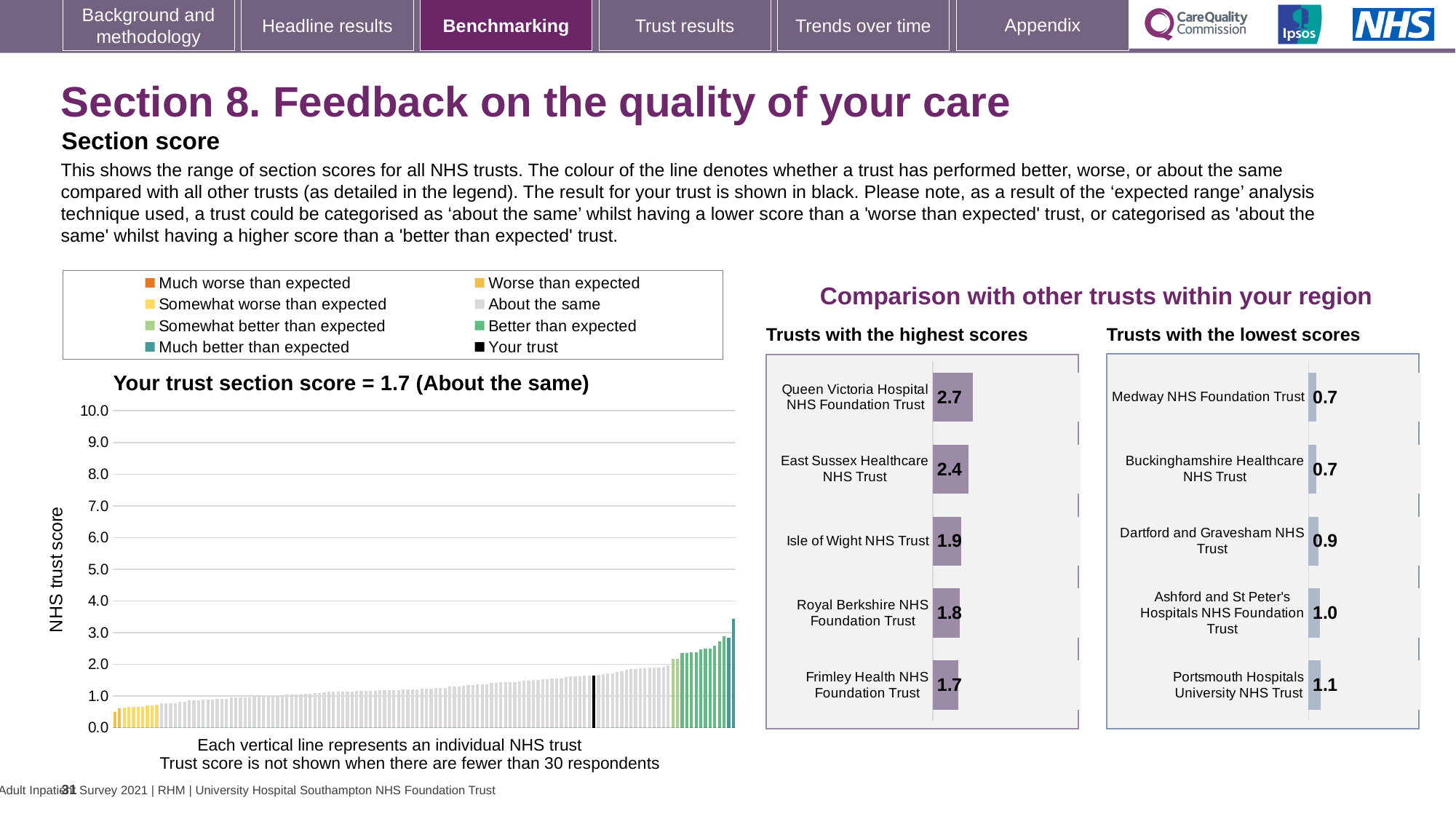
In the 'Trusts with the lowest scores' chart, what is the difference between the scores of Portsmouth Hospitals University NHS Trust and Medway NHS Foundation Trust? 0.4 In the 'Trusts with the lowest scores' chart, which trust has the highest score? Portsmouth Hospitals University NHS Trust In the 'Your trust section score' chart, what is the section score for your trust? 1.7 In the 'Trusts with the highest scores' chart, what is the score for Isle of Wight NHS Trust? 1.9 In the 'Trusts with the lowest scores' chart, what is the score for Dartford and Gravesham NHS Trust? 0.9 In the 'Trusts with the highest scores' chart, which has the larger score: East Sussex Healthcare NHS Trust or Royal Berkshire NHS Foundation Trust? East Sussex Healthcare NHS Trust In the 'Trusts with the highest scores' chart, which trust has the lowest score? Frimley Health NHS Foundation Trust In the 'Trusts with the highest scores' chart, what is the score for Queen Victoria Hospital NHS Foundation Trust? 2.7 How many entries does the legend above the 'Your trust section score' chart list? 8 In the 'Trusts with the highest scores' chart, what is the difference between the scores of Queen Victoria Hospital NHS Foundation Trust and Frimley Health NHS Foundation Trust? 1.0 In the 'Your trust section score' chart, do the bars rise or fall from left to right? rise How many trusts are listed in the 'Trusts with the lowest scores' chart? 5